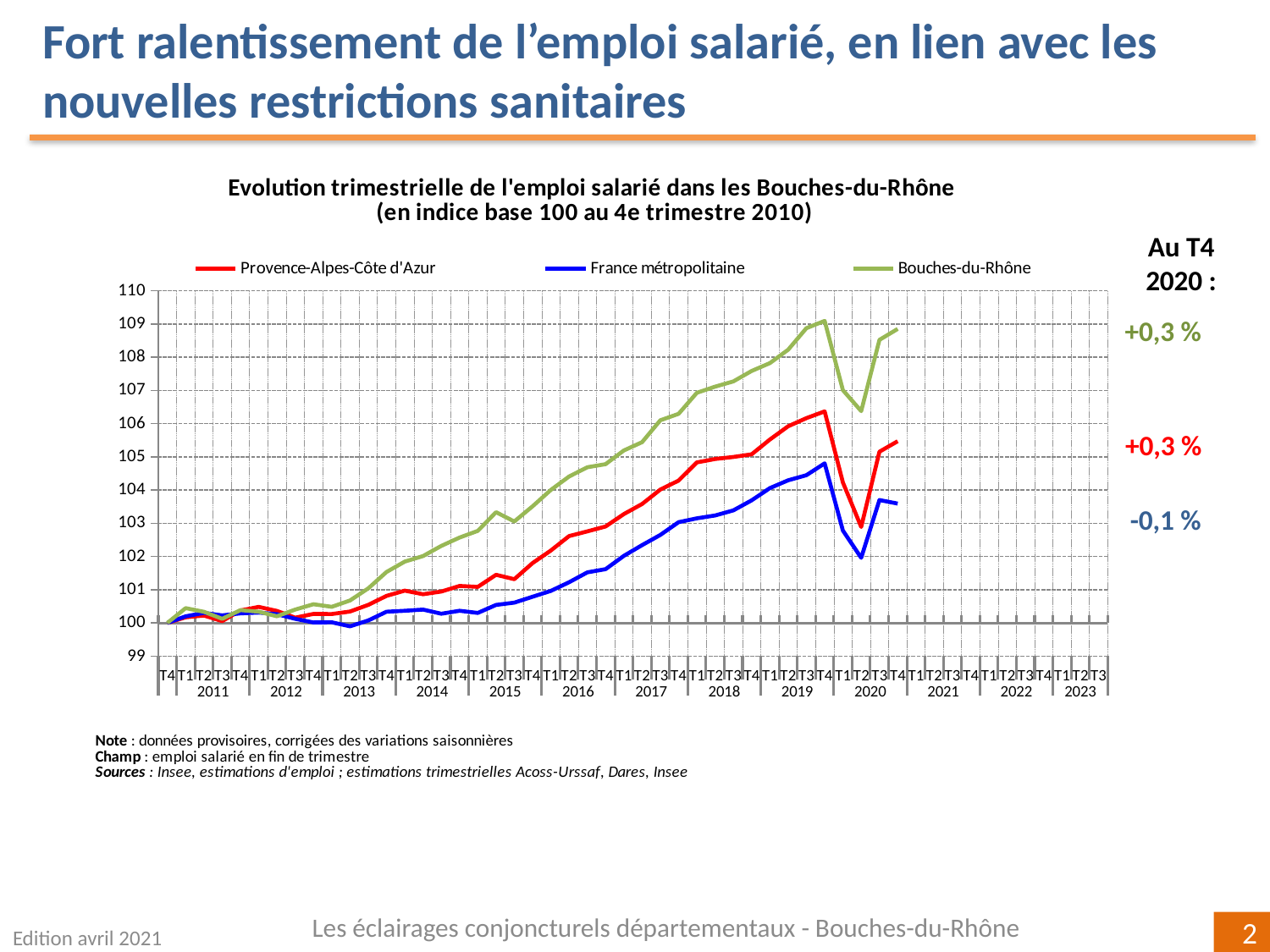
Is the value for France métropolitaine at T2 2020 greater or less than 103? less Is the value for Provence-Alpes-Côte d'Azur at T4 2019 greater or less than 105? greater What kind of chart is shown on the slide? Line chart According to the annotation on the right, what is the change at T4 2020 for France métropolitaine? -0,1 % How many series does the legend of the chart list? 3 At T4 2019, which series is higher: Bouches-du-Rhône or France métropolitaine? Bouches-du-Rhône Which series has the lowest index value at T4 2020? France métropolitaine Between 2011 and 2019, does the Bouches-du-Rhône series generally rise or fall? Rise Is the value for Bouches-du-Rhône at T4 2019 greater or less than 108? greater Which three series are listed in the chart legend? Provence-Alpes-Côte d'Azur, France métropolitaine, Bouches-du-Rhône What is the index value of all three series at T4 2010, the base quarter? 100 Which series reaches the highest index value on the chart? Bouches-du-Rhône